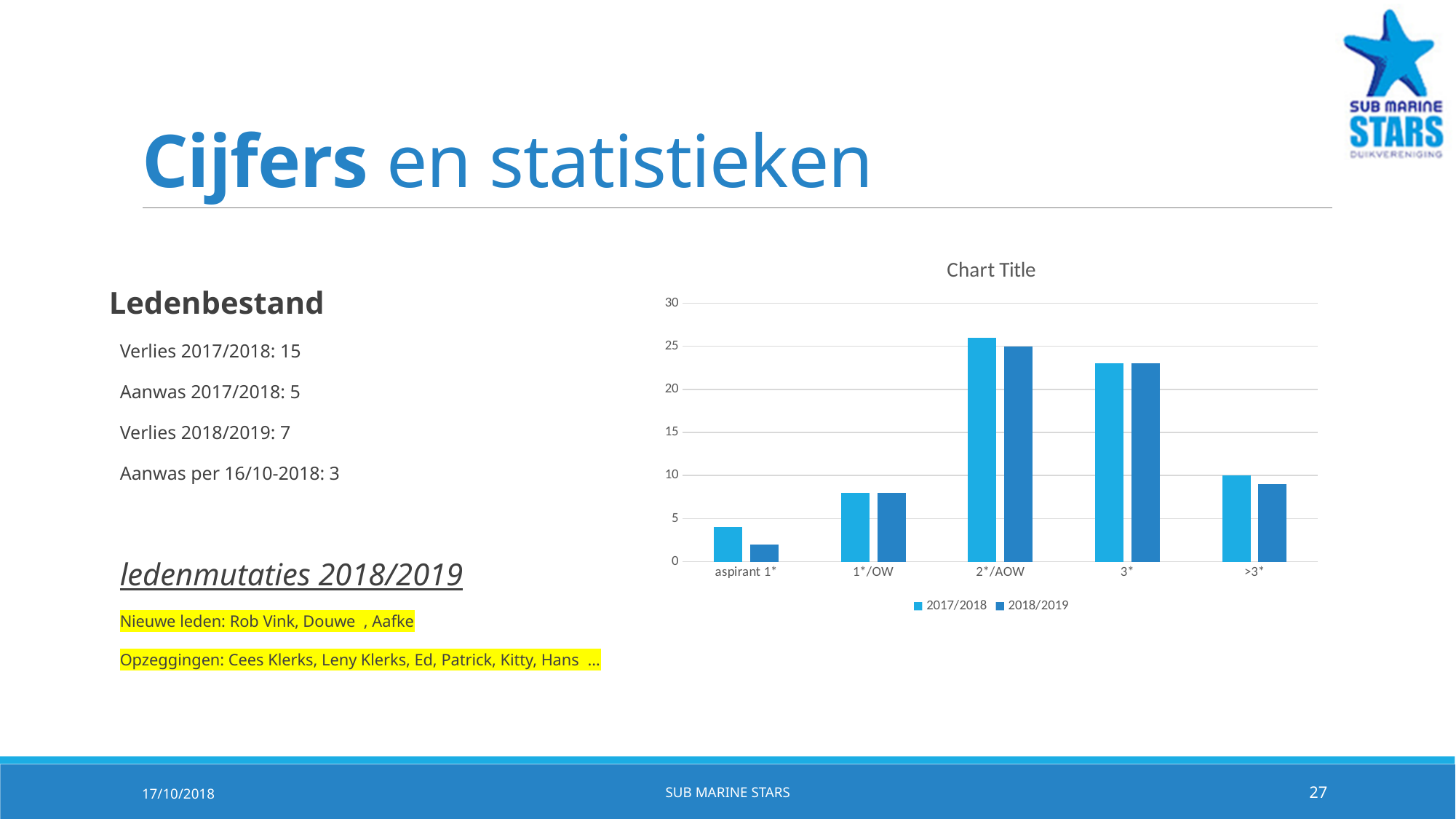
Which category has the highest value for the 2017/2018 series? 2*/AOW How many categories are shown on the x axis of the chart? 5 What is the title shown above the chart? Chart Title Is the 2018/2019 value for aspirant 1* greater or less than 5? less For aspirant 1*, which series has the larger value: 2017/2018 or 2018/2019? 2017/2018 Is the 2017/2018 value for 2*/AOW greater or less than 25? greater What kind of chart is shown on the slide? bar chart For the 2017/2018 series, which is larger: 2*/AOW or 3*? 2*/AOW How many series does the chart legend list? 2 Which category has the lowest value for the 2018/2019 series? aspirant 1* Is the 2018/2019 value for 3* greater or less than 20? greater What are the two series names listed in the chart legend? 2017/2018 and 2018/2019